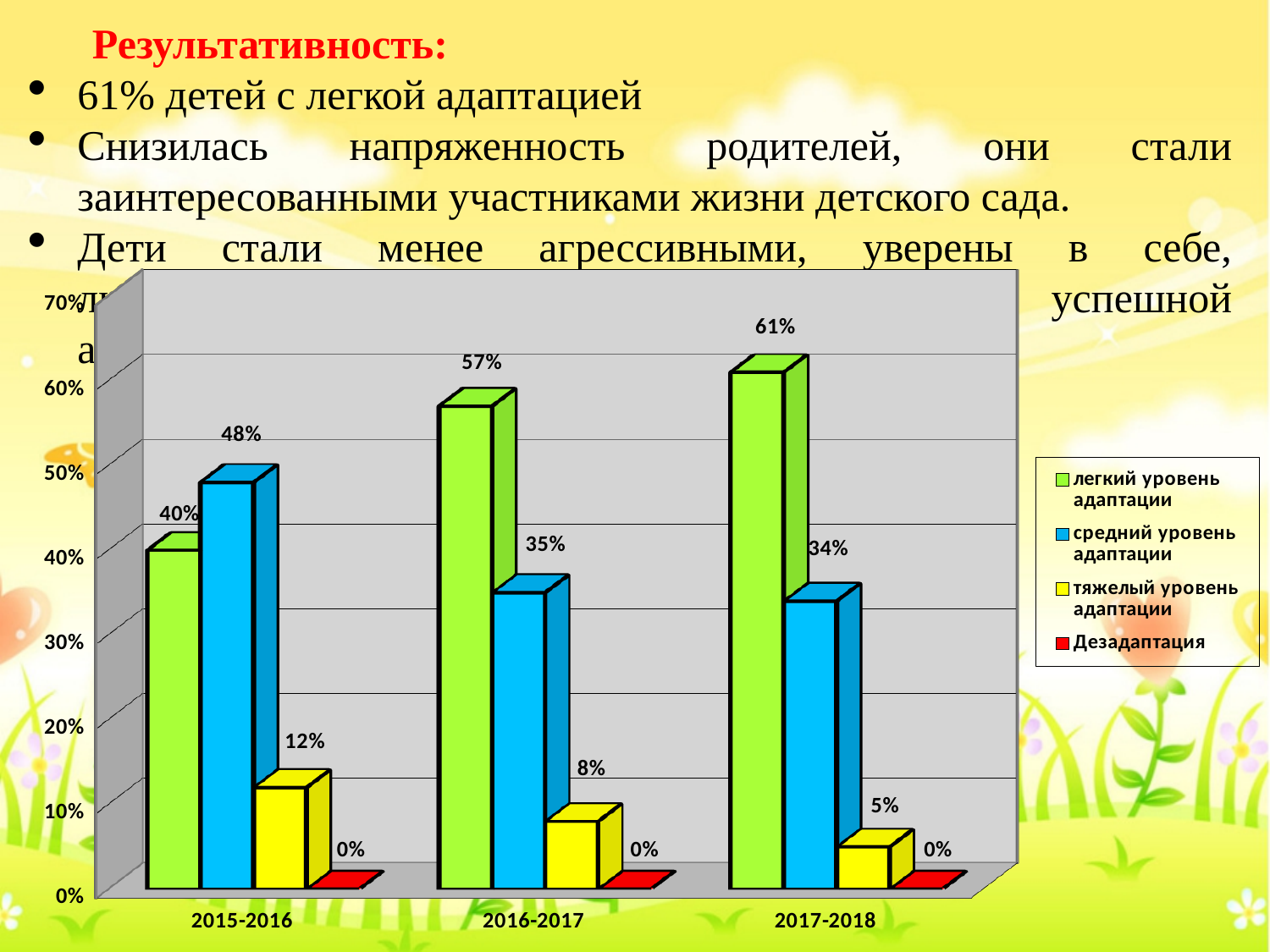
In which period is the value for легкий уровень адаптации the highest? 2017-2018 What is the value for Дезадаптация in 2017-2018? 0% What is the value for тяжелый уровень адаптации in 2016-2017? 8% In which period is the value for тяжелый уровень адаптации the lowest? 2017-2018 What kind of chart is shown on the slide? bar chart What is the value for средний уровень адаптации in 2015-2016? 48% How many series does the legend list? 4 How many periods are shown on the x axis? 3 Which is larger in 2015-2016: легкий уровень адаптации or средний уровень адаптации? средний уровень адаптации What is the difference between легкий уровень адаптации in 2017-2018 and in 2015-2016? 21% What is the value for легкий уровень адаптации in 2017-2018? 61% Does the value for тяжелый уровень адаптации rise or fall from 2015-2016 to 2017-2018? fall